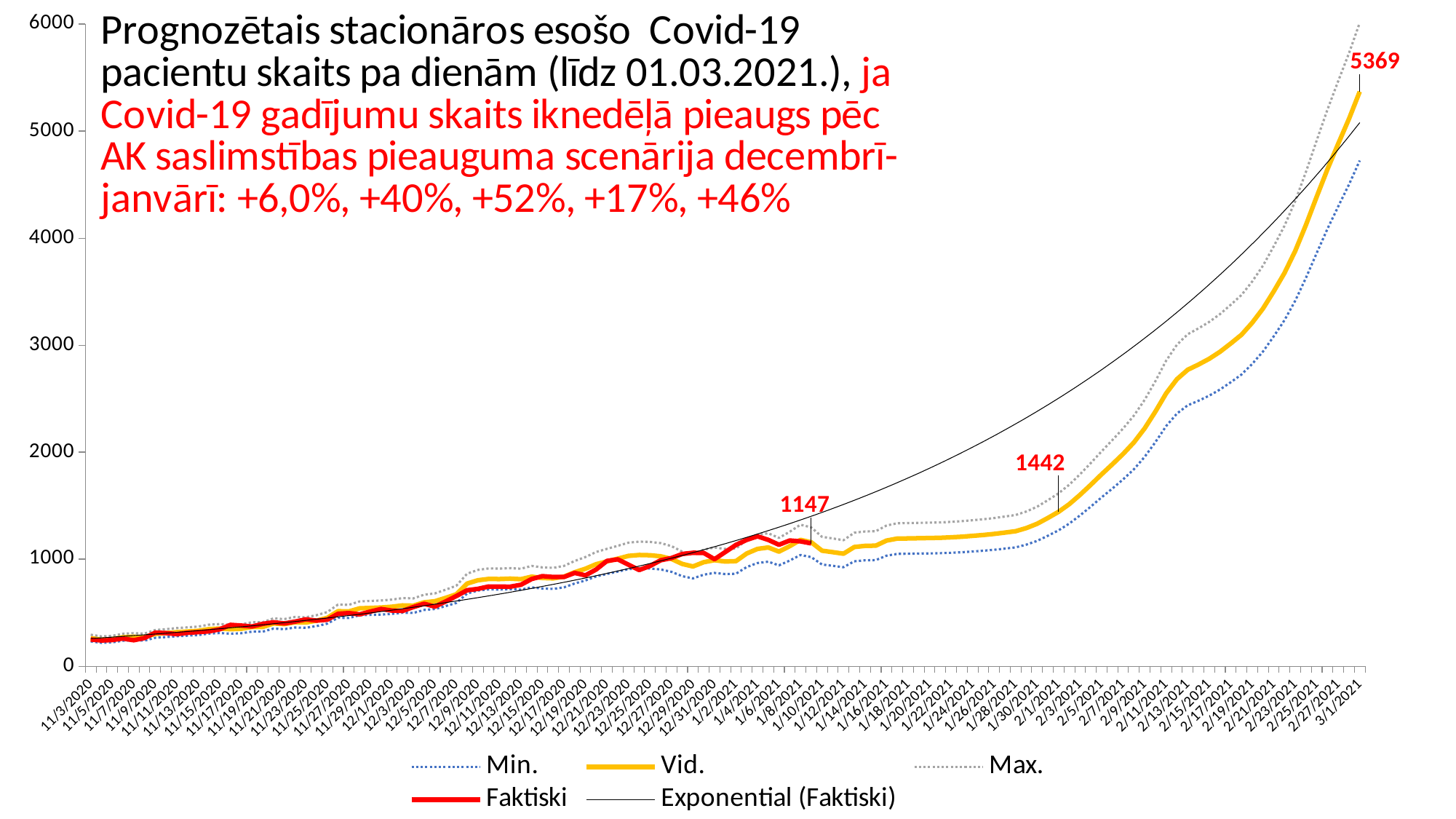
Does the Vid. line rise or fall from 11/3/2020 to 3/1/2021? rise What is the difference between the labelled values 5369 and 1442? 3927 On 3/1/2021, which is larger: the Max. line or the Min. line? Max. What value is labelled at the end of the Vid. line on 3/1/2021? 5369 What kind of chart is shown on the slide? line chart What is the difference between the labelled values 1442 and 1147? 295 How many series does the legend list? 5 Is the value of the Min. line on 3/1/2021 greater or less than 5000? less What value is shown by the data label near 2/1/2021? 1442 Is the value of the Max. line on 3/1/2021 greater or less than 5000? greater What colour is the Faktiski line? red What value is shown by the data label near 1/10/2021 at the end of the Faktiski line? 1147